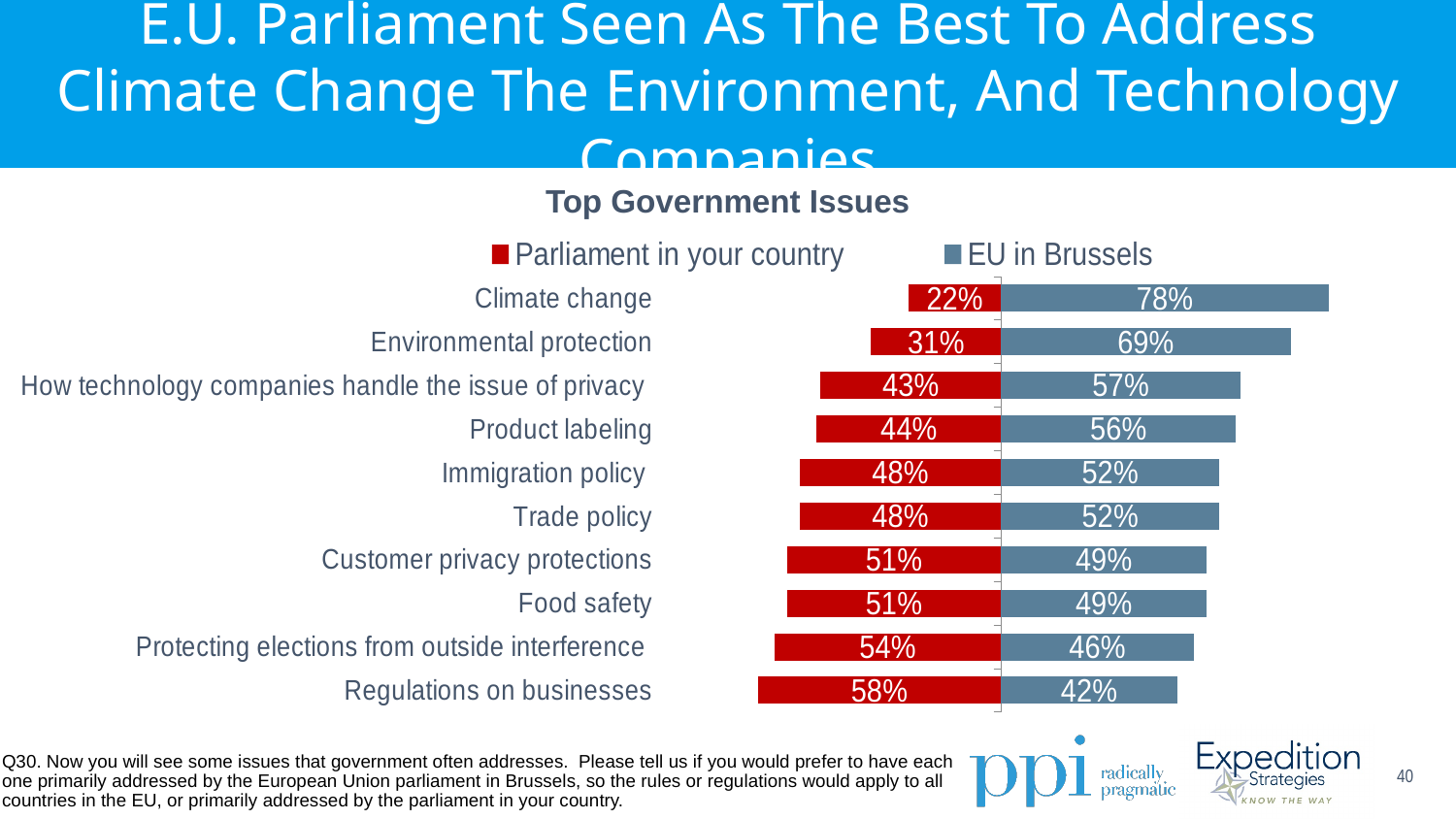
Which category has the lowest 'Parliament in your country' value? Climate change What is the value for 'Parliament in your country' for Regulations on businesses? 58% For Food safety, which is larger: 'Parliament in your country' or 'EU in Brussels'? Parliament in your country What is the title of the chart? Top Government Issues How many series does the legend list? 2 What is the value for 'EU in Brussels' for Climate change? 78% What is the value for 'EU in Brussels' for Protecting elections from outside interference? 46% What is the difference between the 'EU in Brussels' and 'Parliament in your country' values for Environmental protection? 38% What is the value for 'Parliament in your country' for Product labeling? 44% How many categories (issues) are shown in the chart? 10 What kind of chart is shown on the slide? Bar chart Which category has the highest 'EU in Brussels' value? Climate change